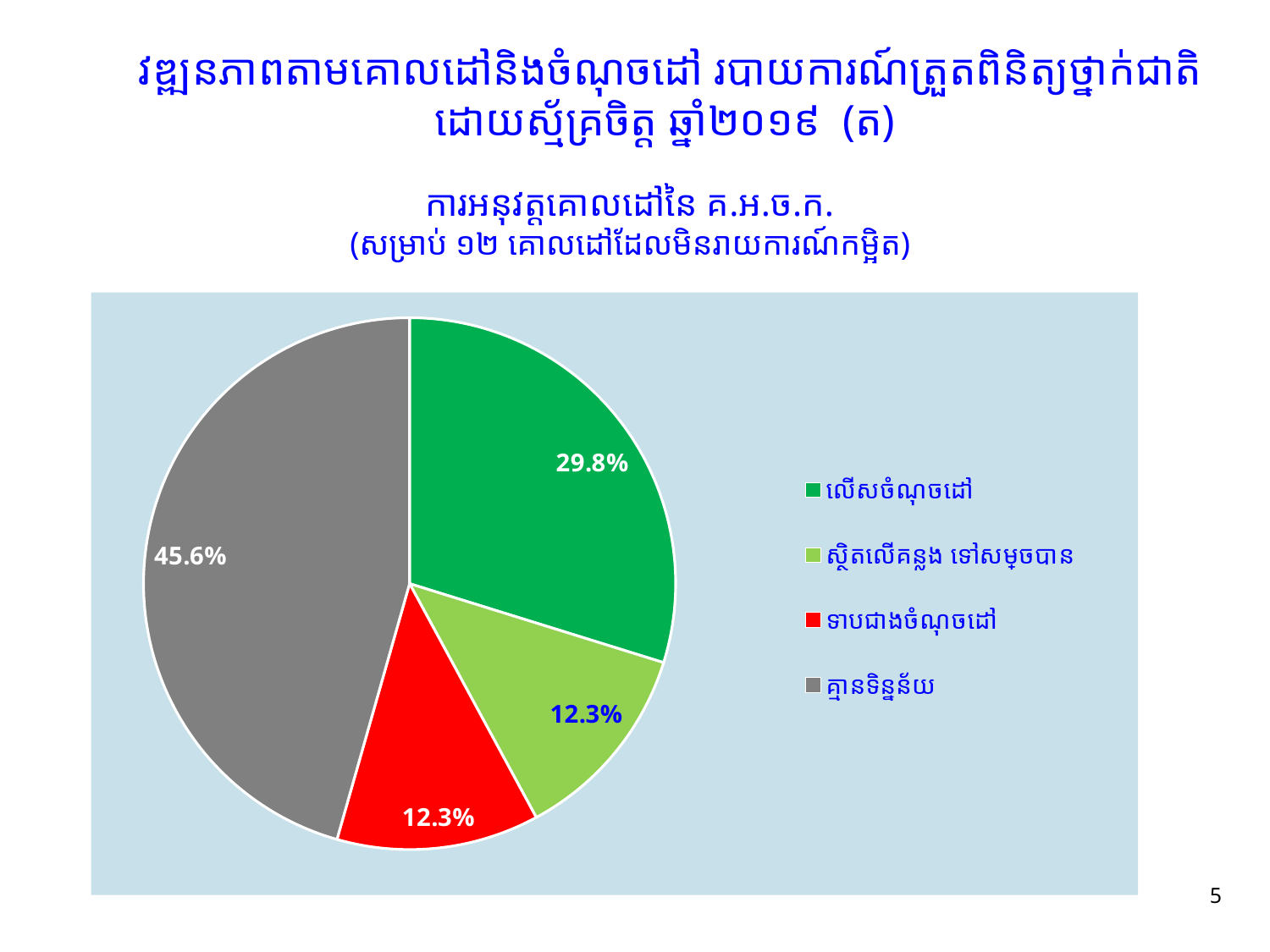
How many slices does the pie chart have? 4 What kind of chart is shown on the slide? pie chart What colour is the slice labelled គ្មានទិន្នន័យ in the pie chart? grey What is the value shown for the slice labelled ទាបជាងចំណុចដៅ (red)? 12.3% What is the value shown for the slice labelled ស្ថិតលើគន្លង ទៅសម្រេចបាន (light green)? 12.3% How many entries does the legend of the pie chart list? 4 Which is larger: the slice for លើសចំណុចដៅ or the slice for ទាបជាងចំណុចដៅ? លើសចំណុចដៅ What is the value shown for the slice labelled គ្មានទិន្នន័យ (grey)? 45.6% What is the value shown for the slice labelled លើសចំណុចដៅ (dark green)? 29.8% What share of the pie do the two 12.3% slices (ស្ថិតលើគន្លង ទៅសម្រេចបាន and ទាបជាងចំណុចដៅ) make up together? 24.6% What is the difference between the គ្មានទិន្នន័យ slice and the លើសចំណុចដៅ slice? 15.8% Which slice of the pie chart is the largest? គ្មានទិន្នន័យ